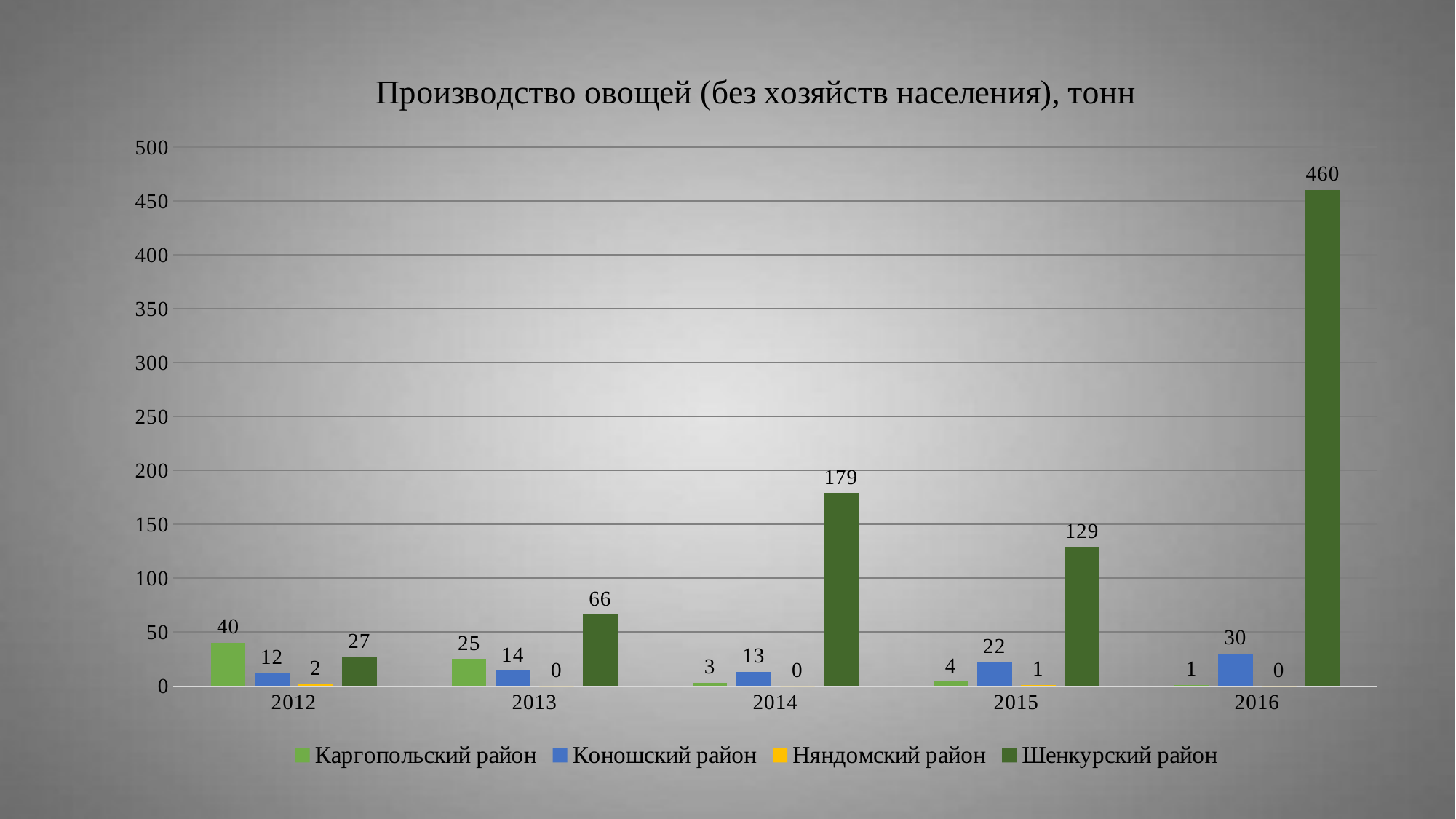
What is the value for Каргопольский район in 2012? 40 What is the value for Коношский район in 2015? 22 In which year is the value for Каргопольский район lowest? 2016 What kind of chart is shown on the slide? Bar chart What is the difference between the Шенкурский район values in 2014 and 2015? 50 What is the value for Няндомский район in 2013? 0 What is the value for Шенкурский район in 2016? 460 Is the value for Шенкурский район in 2014 greater or less than 150? greater How many years are shown on the x axis? 5 In which year is the value for Шенкурский район highest? 2016 How many series does the legend list? 4 Which is larger in 2013: Каргопольский район or Коношский район? Каргопольский район